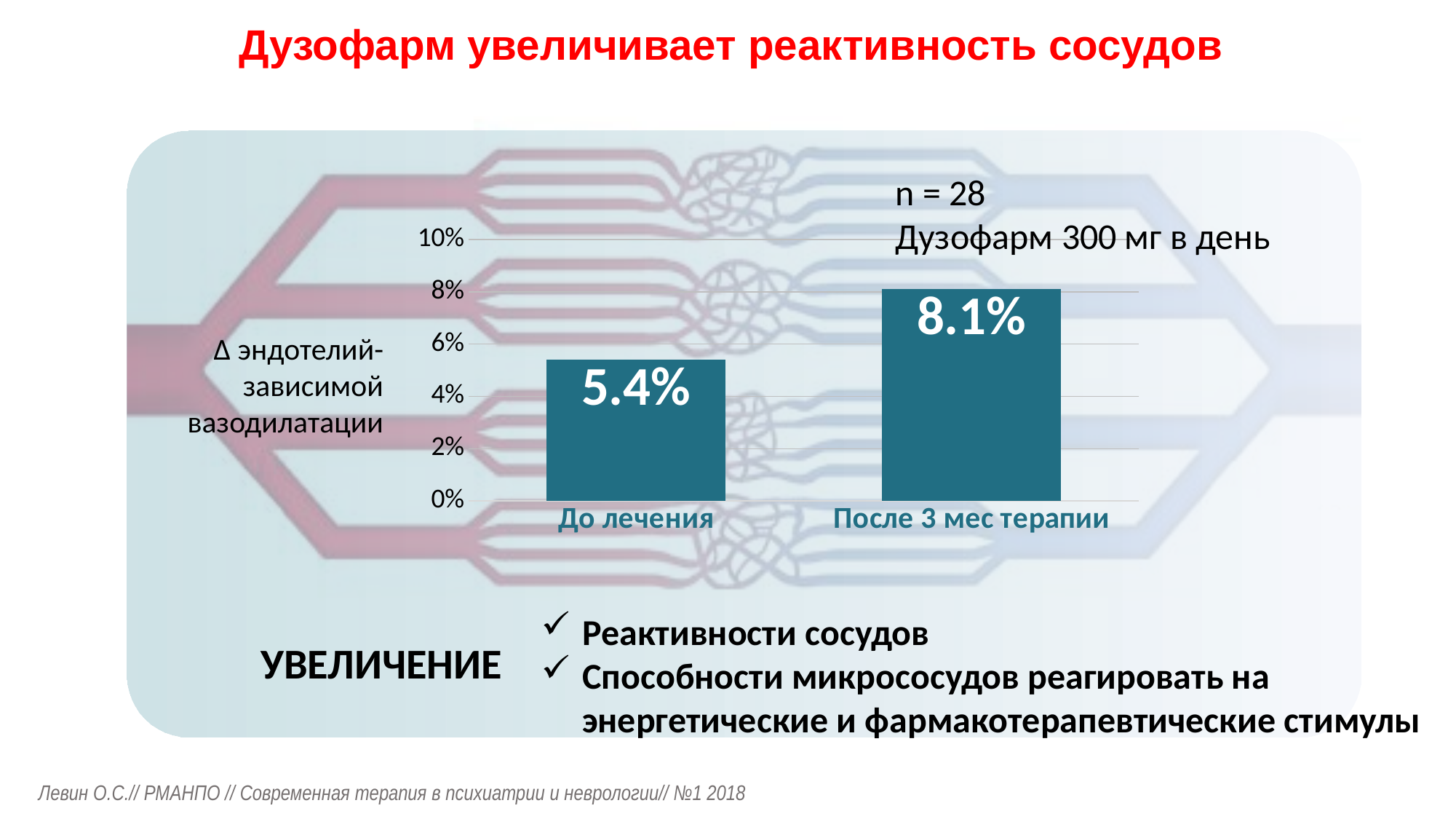
Which category has the lowest value? До лечения Which category has the highest value? После 3 мес терапии Is the value for "До лечения" greater or less than 6%? less Is the value for "После 3 мес терапии" greater or less than 8%? greater What is the difference between the values for "После 3 мес терапии" and "До лечения"? 2.7% How many categories are shown in the chart? 2 What is the label on the vertical axis of the chart? Δ эндотелий-зависимой вазодилатации Do the values rise or fall from "До лечения" to "После 3 мес терапии"? Rise What is the value for "После 3 мес терапии"? 8.1% What is the value for "До лечения"? 5.4% Which is larger, the value for "До лечения" or for "После 3 мес терапии"? После 3 мес терапии What kind of chart is shown on the slide? Bar chart